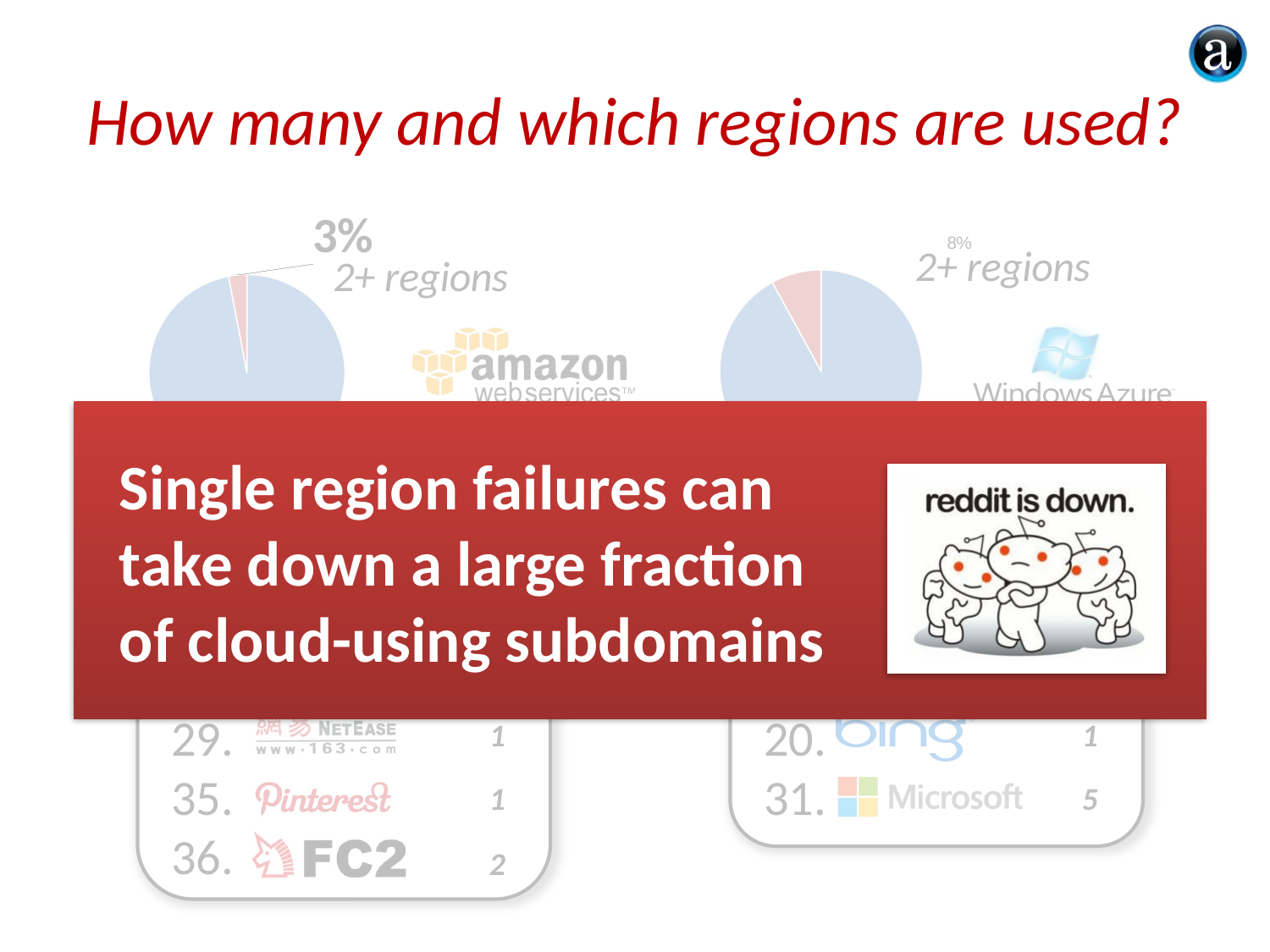
How many pie charts are shown on the slide? 2 In the left pie chart (Amazon Web Services), is the "2+ regions" slice the smaller or the larger slice of the pie? Smaller In the right pie chart (Windows Azure), what share of the pie is labelled "2+ regions"? 8% What kind of chart is shown on the left of the slide, next to the Amazon Web Services logo? Pie chart Which pie chart has the larger "2+ regions" slice, the Amazon Web Services one or the Windows Azure one? Windows Azure In the left pie chart (Amazon Web Services), what share of the pie is labelled "2+ regions"? 3% How many slices does the left pie chart (Amazon Web Services) have? 2 Which cloud provider's logo appears next to the right pie chart? Windows Azure What is the difference in percentage points between the "2+ regions" share in the Windows Azure pie chart and the "2+ regions" share in the Amazon Web Services pie chart? 5 percentage points What is the title of the slide containing the two pie charts? How many and which regions are used?